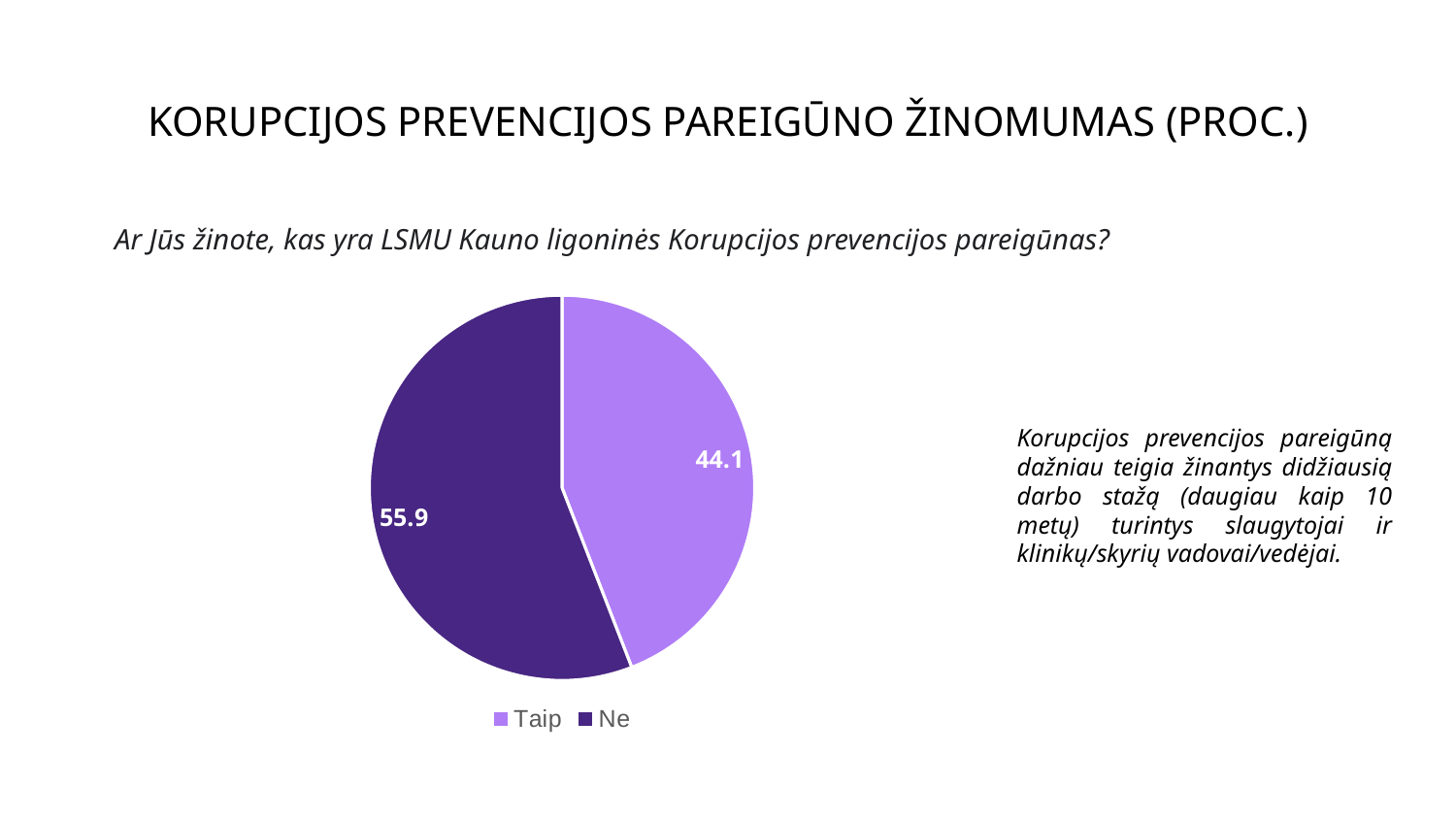
Which slice of the pie chart is the largest? Ne What is the difference between the "Ne" and "Taip" values in the pie chart? 11.8 What kind of chart is shown on the slide? pie chart Which is larger in the pie chart, "Taip" or "Ne"? Ne What is the value for "Ne" in the pie chart? 55.9 How many slices does the pie chart have? 2 What is the total of the two values shown in the pie chart? 100 What is the value for "Taip" in the pie chart? 44.1 How many entries does the legend of the pie chart list? 2 Which slice of the pie chart is the smallest? Taip Which legend entry is shown in the darker purple colour? Ne What share of the pie does the "Taip" slice represent? 44.1%